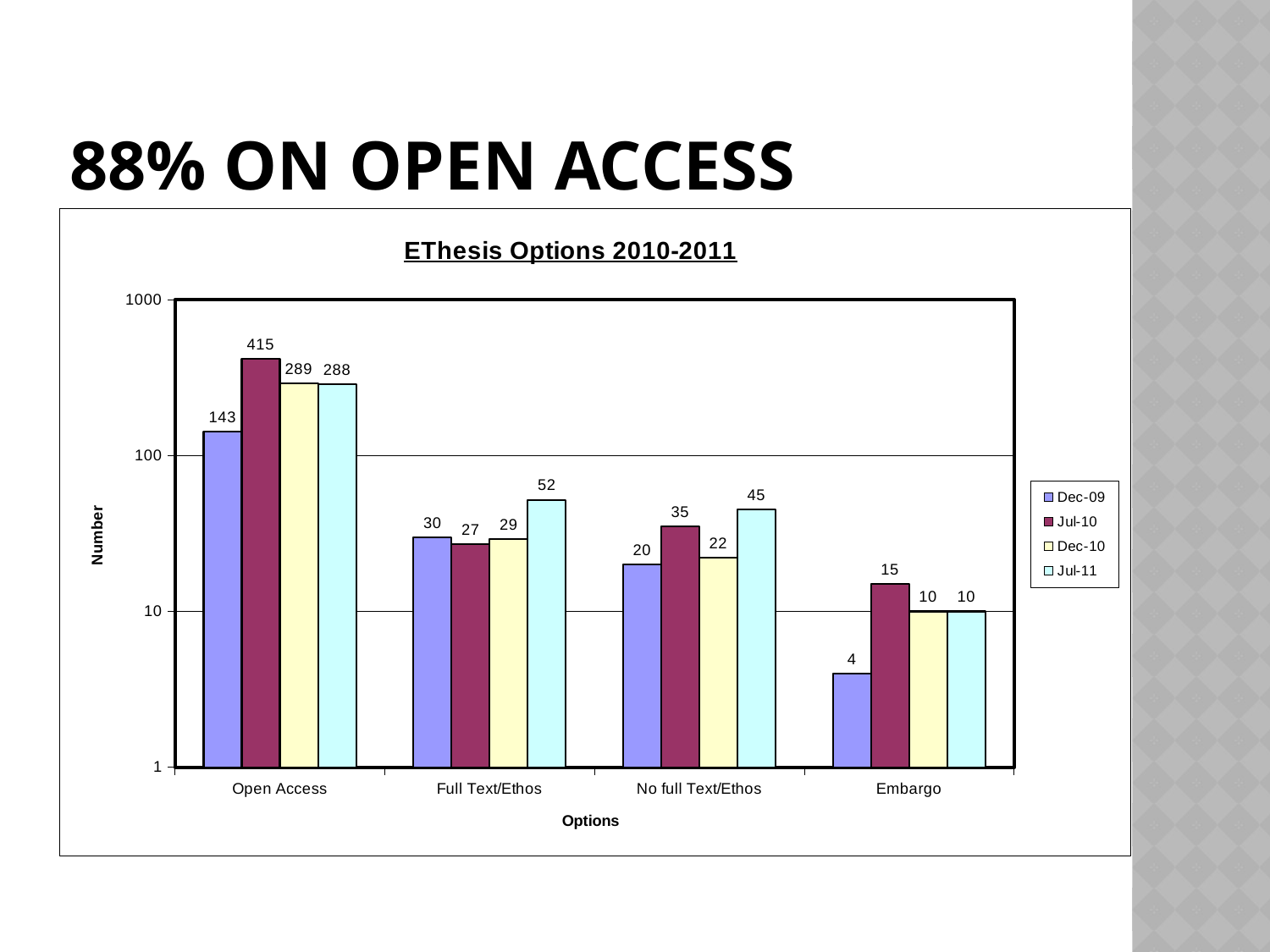
Which category has the lowest value in the Jul-10 series? Embargo What is the difference between the Jul-10 and Dec-09 values for Open Access? 272 What is the value for No full Text/Ethos in the Jul-11 series? 45 Which is larger for Full Text/Ethos: the Dec-09 value or the Jul-11 value? Jul-11 Is the value for Open Access in the Dec-09 series greater or less than 100? greater What is the title of the chart? EThesis Options 2010-2011 Which category has the highest value in the Dec-10 series? Open Access How many series does the legend list? 4 How many categories are shown on the x axis? 4 What is the value for Embargo in the Dec-09 series? 4 What is the value for Open Access in the Jul-10 series? 415 What kind of chart is shown? bar chart